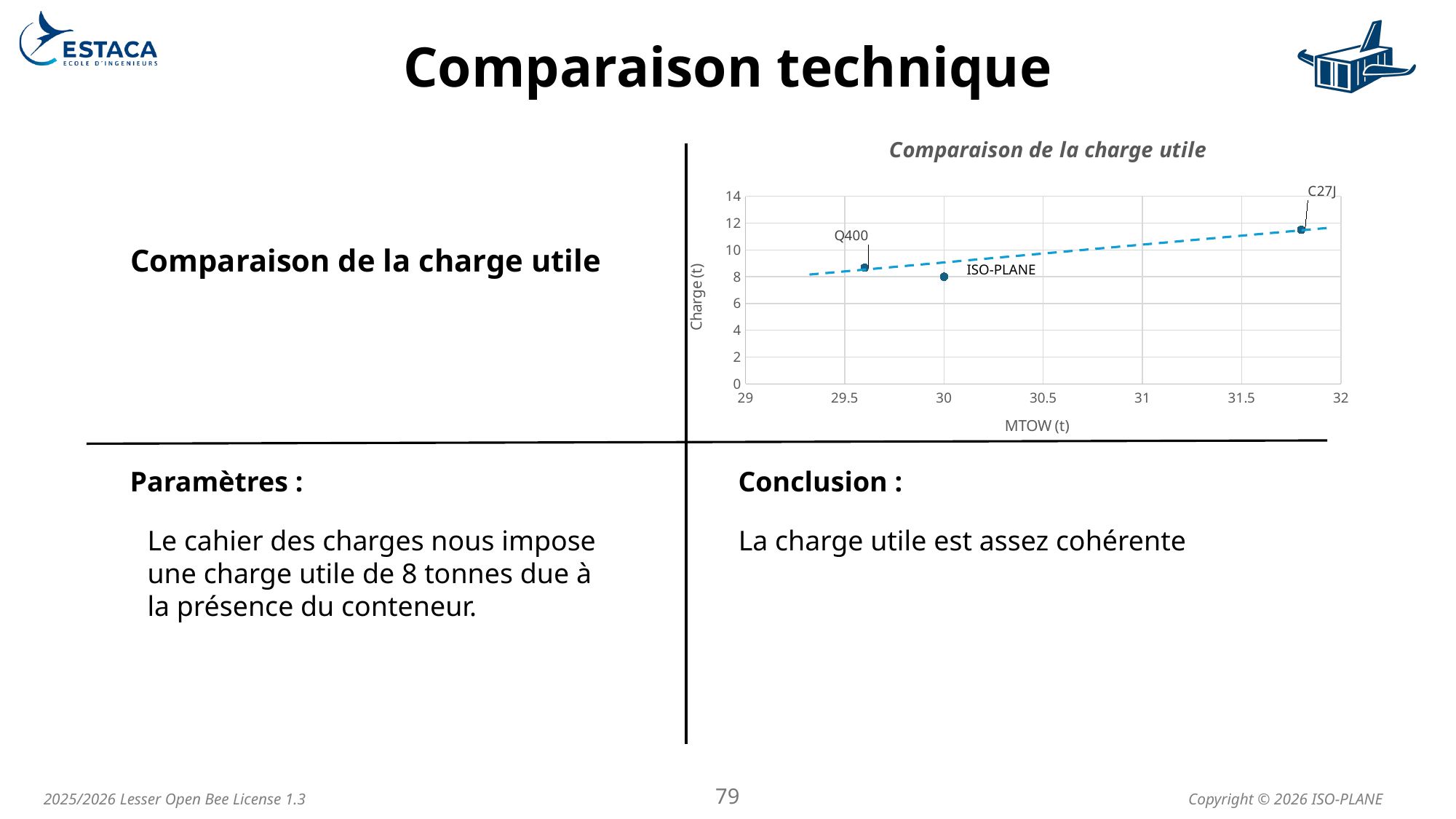
What is the MTOW (t) of ISO-PLANE on the chart? 30 Which aircraft has the highest charge utile on the chart? C27J What kind of chart is shown on the slide? scatter chart Is the charge utile for Q400 greater or less than 10? less What is the title of the chart? Comparaison de la charge utile Which has a larger charge utile, Q400 or C27J? C27J What is the charge utile (t) of ISO-PLANE on the chart? 8 Which aircraft has the lowest charge utile on the chart? ISO-PLANE How many aircraft data points are plotted on the chart? 3 Is the charge utile for C27J greater or less than 10? greater Is the MTOW for C27J greater or less than 31.5? greater Does the dashed trend line rise or fall as MTOW increases? rises